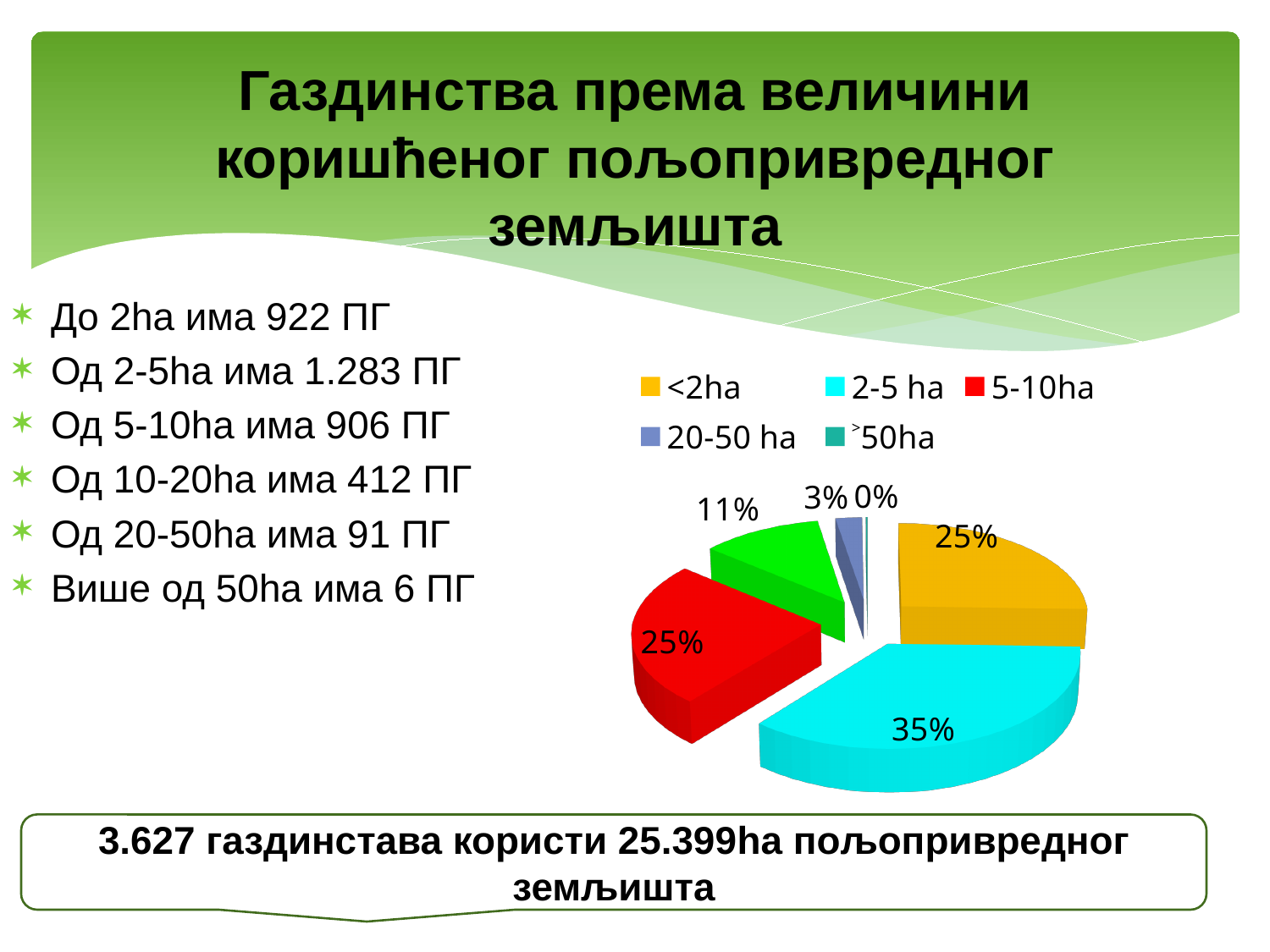
What share of the pie does the 5-10ha slice represent? 25% How many entries does the chart legend list? 5 What colour is the 2-5 ha slice in the pie chart? cyan What share of the pie does the >50ha slice represent? 0% Which category has the largest slice of the pie? 2-5 ha Which category has the smallest slice of the pie? >50ha What share of the pie does the <2ha slice represent? 25% What is the difference in percentage points between the 2-5 ha slice and the <2ha slice? 10 percentage points What kind of chart is shown on the slide? pie chart Which slice is larger, 2-5 ha or 20-50 ha? 2-5 ha